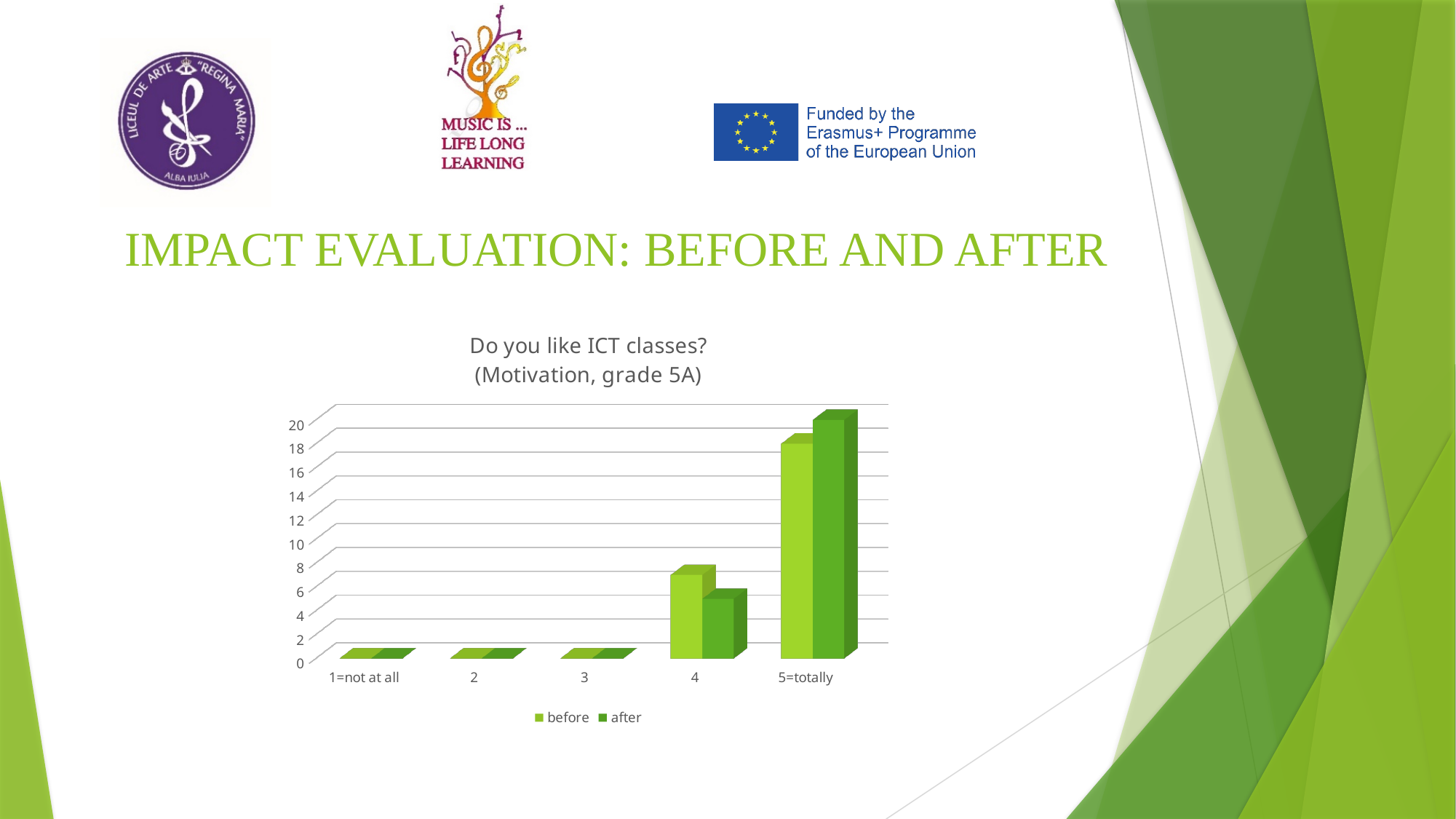
Which category has the highest value for the 'after' series? 5=totally How many categories are shown on the x axis of the chart? 5 Is the 'before' value for category 5=totally greater or less than 10? greater For category 5=totally, which series has the larger value, 'before' or 'after'? after For category 4, which series has the larger value, 'before' or 'after'? before What is the title of the chart? Do you like ICT classes? (Motivation, grade 5A) How many series does the chart legend list? 2 Which category has the highest value for the 'before' series? 5=totally What kind of chart is shown on the slide? bar chart Is the 'before' value for category 4 greater or less than 10? less What are the two series named in the chart legend? before and after Is the 'after' value for category 5=totally greater or less than 16? greater